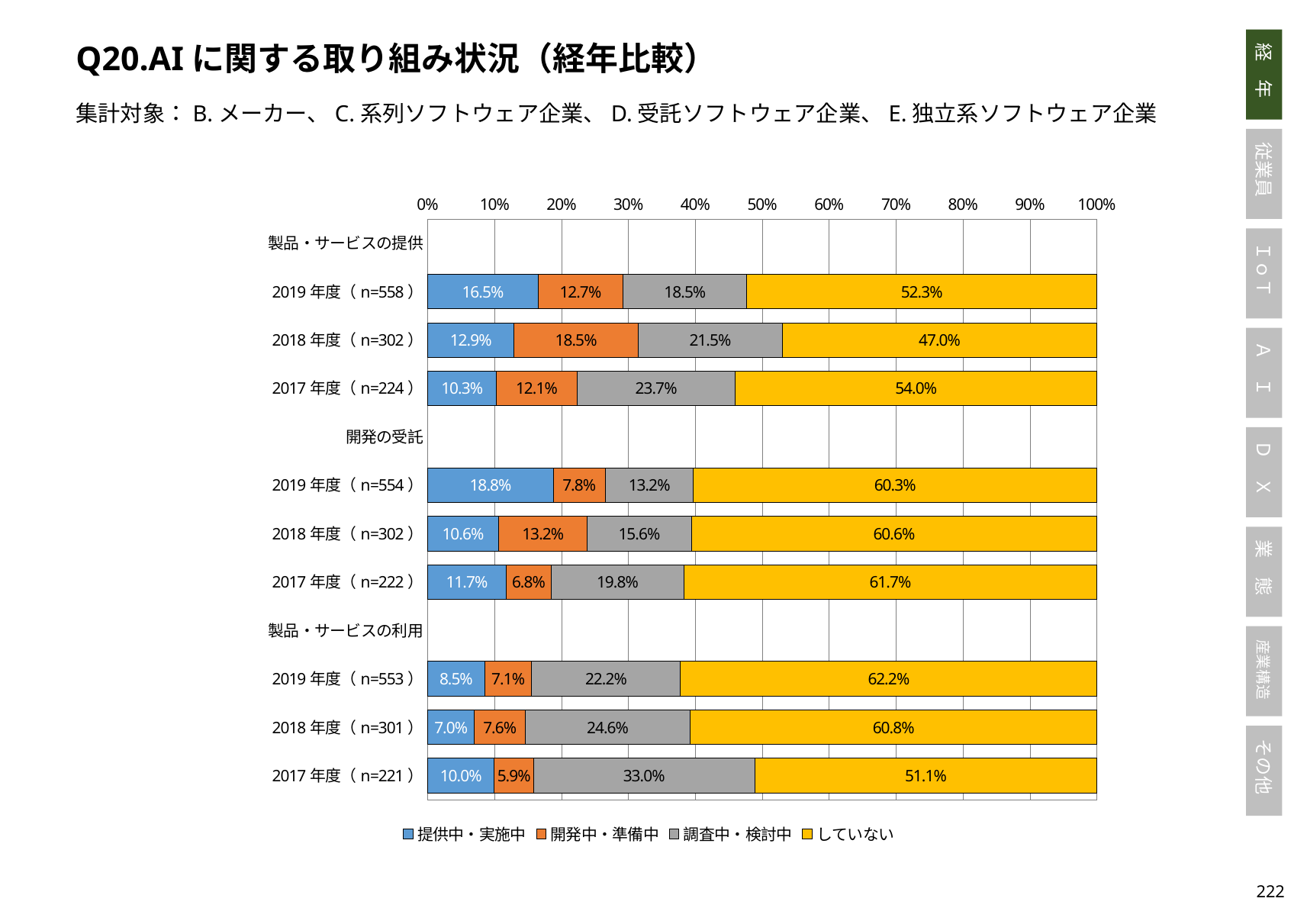
Within the 製品・サービスの利用 group, which year has the lowest value for 開発中・準備中? 2017年度 (n=221) Within the 製品・サービスの提供 group, which year has the highest value for していない? 2017年度 (n=224) What kind of chart is shown on the slide? Stacked bar chart How many series does the legend list? 4 In the 開発の受託 group, what is the value for 調査中・検討中 in 2017年度 (n=222)? 19.8% In the 製品・サービスの提供 group, how much higher is 提供中・実施中 in 2019年度 than in 2017年度? 6.2 percentage points In the 製品・サービスの提供 group, what percentage is shown for していない in 2019年度 (n=558)? 52.3% How many bars are plotted in the chart? 9 For 2019年度, is the 提供中・実施中 share larger in the 開発の受託 group or the 製品・サービスの提供 group? 開発の受託 In the 製品・サービスの利用 group, what is the value for 提供中・実施中 in 2018年度 (n=301)? 7.0% In the 製品・サービスの提供 group, does the 提供中・実施中 share rise or fall from 2017年度 to 2019年度? Rises Which legend entry is shown in yellow? していない